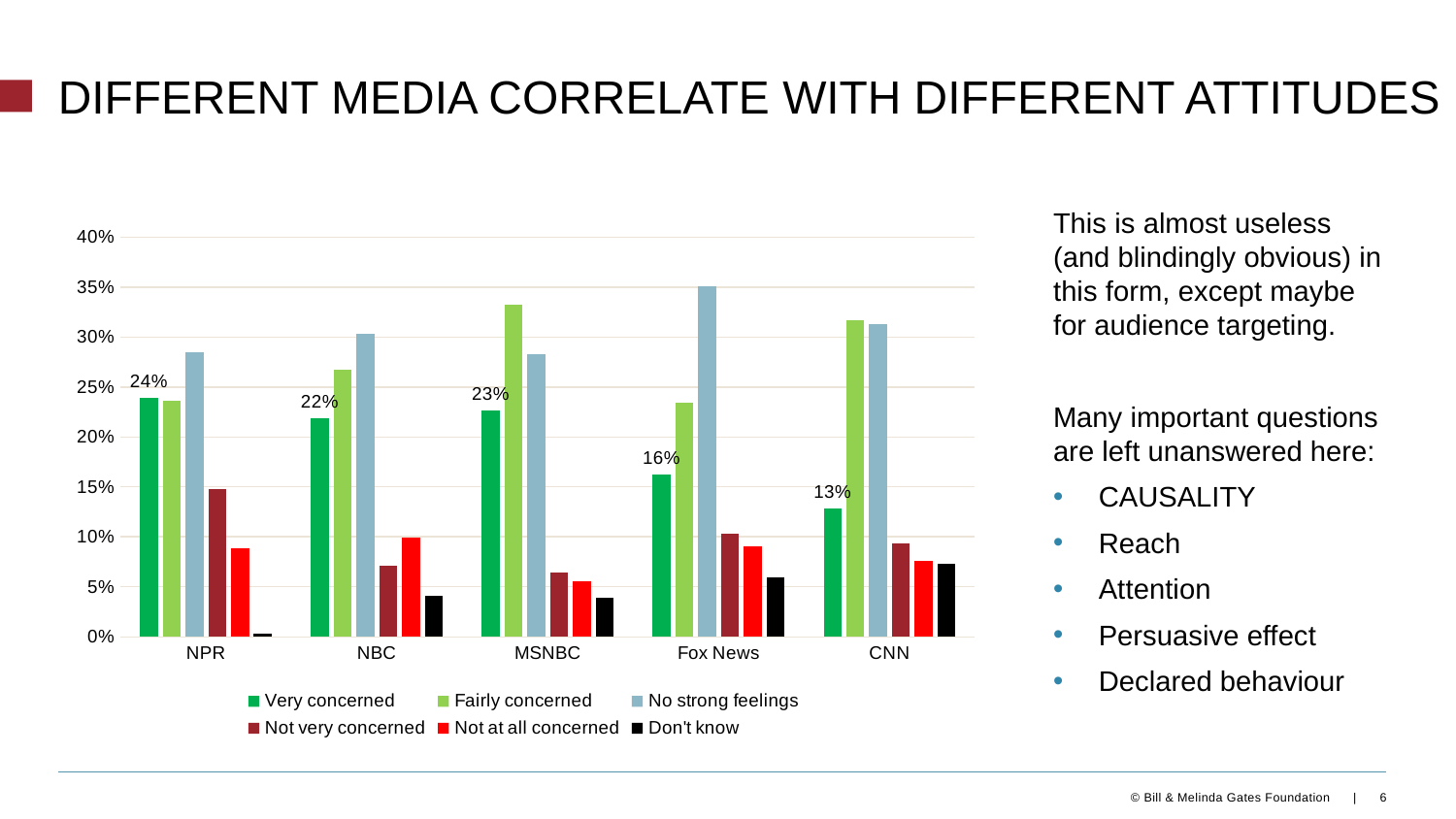
What is the value for Very concerned for CNN? 13% Which media outlet has the lowest Very concerned value? CNN Is the value for Not very concerned for MSNBC greater or less than 10%? less How many series does the legend list? 6 How many media outlets are shown on the x axis? 5 What is the difference between the Very concerned values for NPR and CNN? 11 percentage points Is the value for No strong feelings for Fox News greater or less than 30%? greater Which has the larger Very concerned value, NBC or MSNBC? MSNBC What is the value for Very concerned for NPR? 24% Which media outlet has the highest Very concerned value? NPR What is the value for Very concerned for Fox News? 16% What kind of chart is shown on the slide? Bar chart